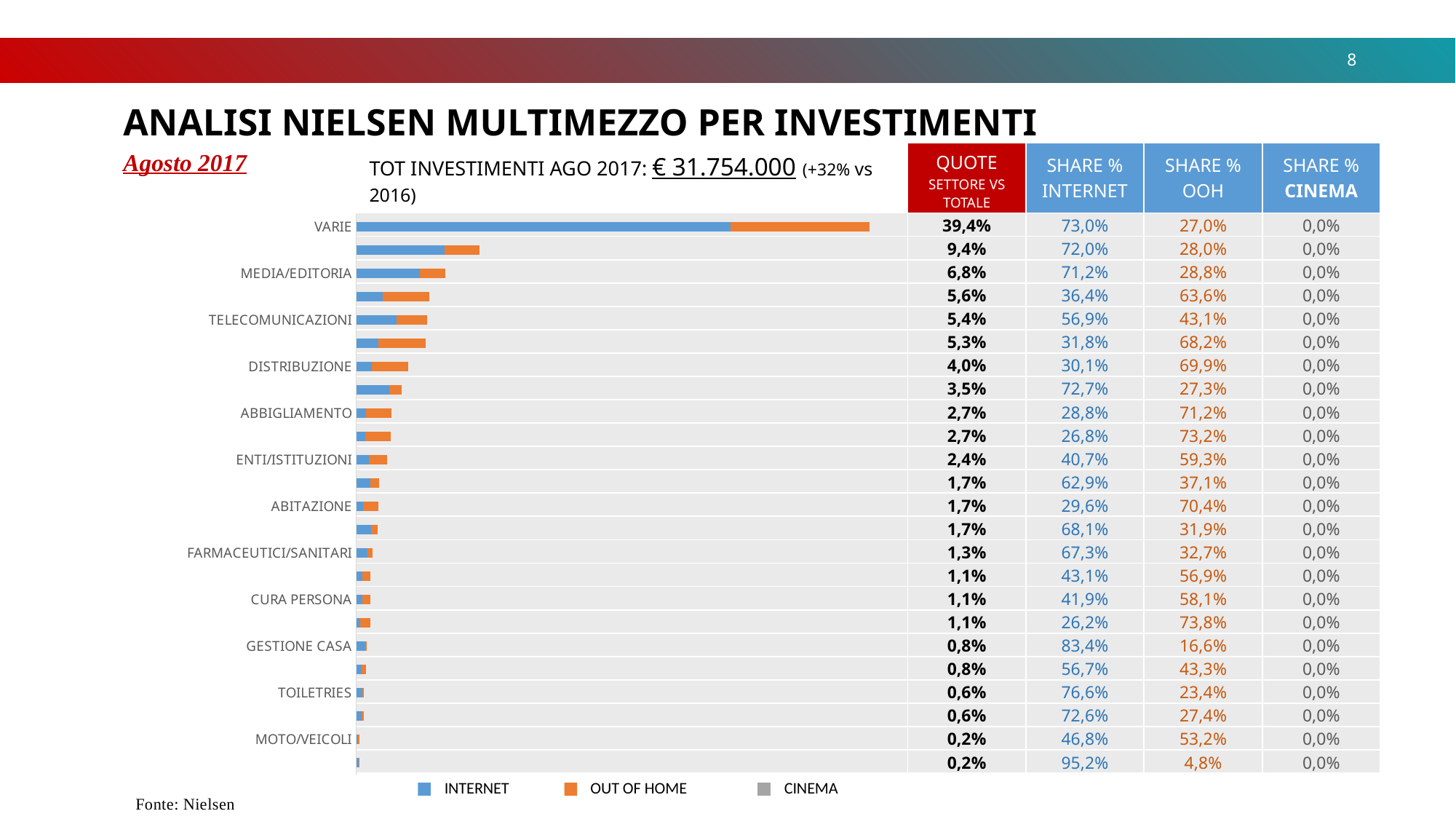
For VARIE, which segment is larger: INTERNET or OUT OF HOME? INTERNET What kind of chart is shown on the slide? Stacked horizontal bar chart How many bars (sectors) are plotted in the chart? 24 Which sector has the longest bar in the chart? VARIE What is the SHARE % INTERNET value for TELECOMUNICAZIONI? 56,9% What is the SHARE % OOH value for DISTRIBUZIONE? 69,9% What total investment figure for August 2017 is stated above the chart? € 31.754.000 What is the difference between the QUOTE SETTORE VS TOTALE of VARIE and that of MEDIA/EDITORIA? 32,6% What is the SHARE % INTERNET value for GESTIONE CASA? 83,4% What is the QUOTE SETTORE VS TOTALE value for VARIE? 39,4% How many series does the chart legend list? 3 Do the bar lengths increase or decrease going from the top of the chart to the bottom? Decrease